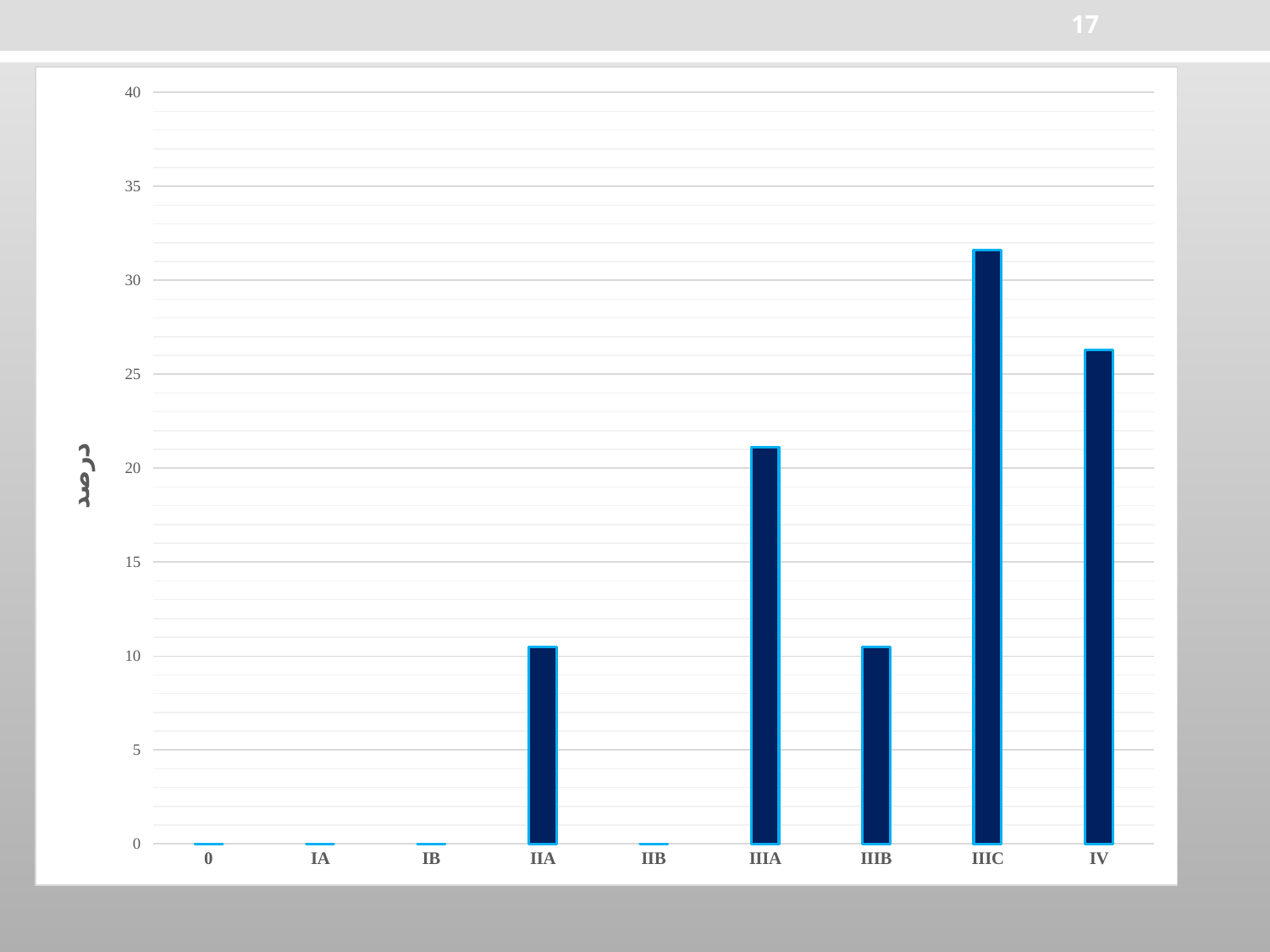
Is the value for IV greater or less than 30? less What kind of chart is shown on the slide? bar chart Which category has the highest value in the chart? IIIC Which is larger, the value for IIIC or the value for IV? IIIC Which is larger, the value for IIIA or the value for IIA? IIIA What is the label on the vertical axis of the chart? درصد Is the value for IV greater or less than 25? greater Is the value for IIIA greater or less than 20? greater How many categories are shown on the x axis of the chart? 9